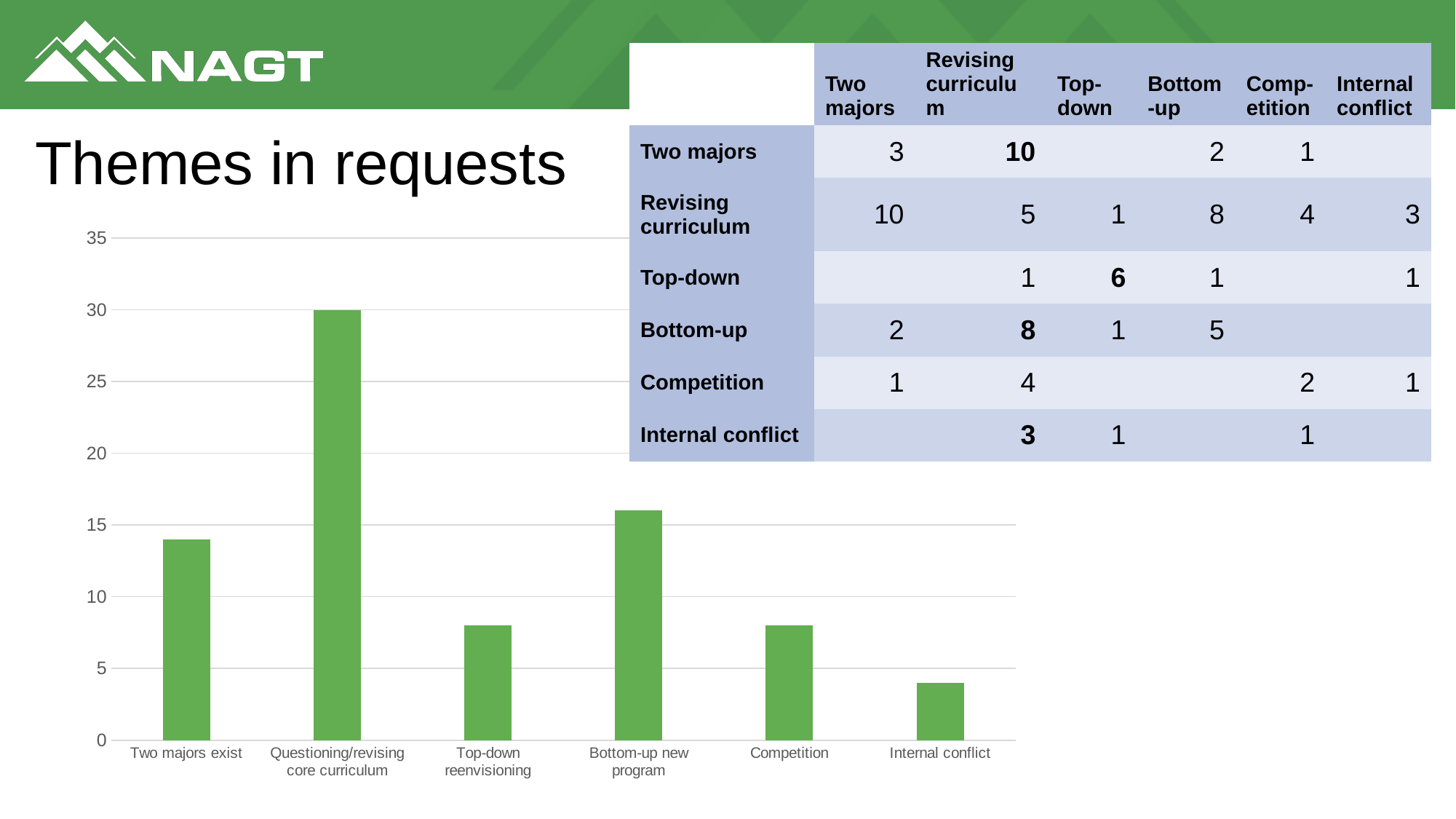
Is the value for Two majors exist greater or less than 10? greater What is the value for Questioning/revising core curriculum? 30 Is the value for Bottom-up new program greater or less than 15? greater What is the title of the slide containing the chart? Themes in requests What type of chart is shown on the slide? bar chart Which category has the highest bar in the chart? Questioning/revising core curriculum Which category has the lowest bar in the chart? Internal conflict Is the value for Internal conflict greater or less than 5? less What colour are the bars in the chart? green Which is larger, the value for Two majors exist or the value for Competition? Two majors exist How many categories are shown on the x axis of the bar chart? 6